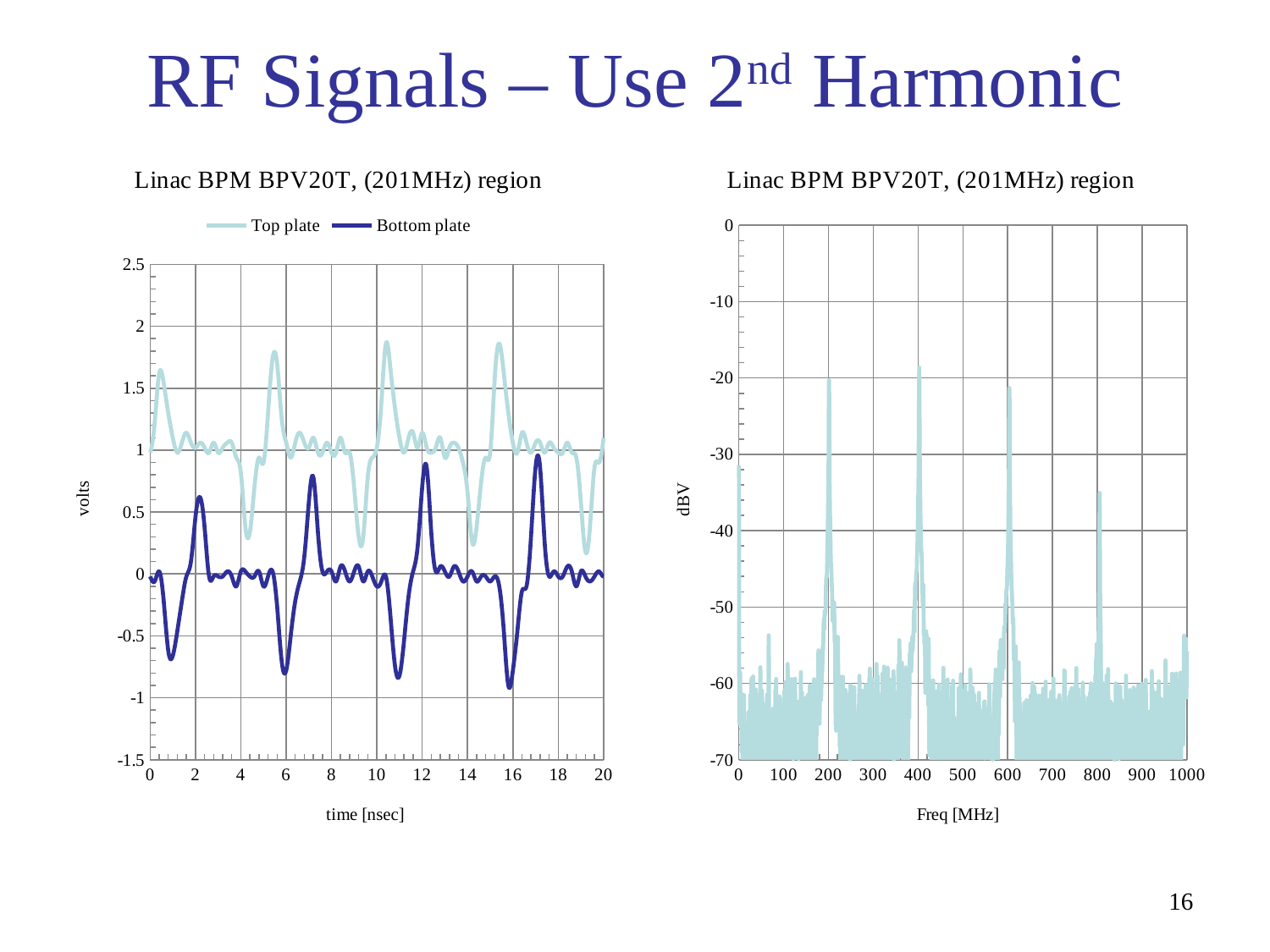
In the right chart, near which frequency on the x axis does the highest peak occur? 400 MHz In the left chart, is the highest value reached by the Top plate series greater or less than 1.5 volts? greater In the right chart, is the peak near 200 MHz greater or less than -30 dBV? greater What are the two series named in the legend of the left chart? Top plate and Bottom plate In the left chart, is the Bottom plate series mostly above or below the Top plate series? below What is the x-axis label of the left chart? time [nsec] In the right chart, which peak is higher, the one near 400 MHz or the one near 800 MHz? 400 MHz How many series does the legend of the left chart list? 2 In the right chart, is the peak near 800 MHz greater or less than -30 dBV? less What kind of chart is the left chart on the slide? line chart In the left chart, which series reaches higher peak values, Top plate or Bottom plate? Top plate